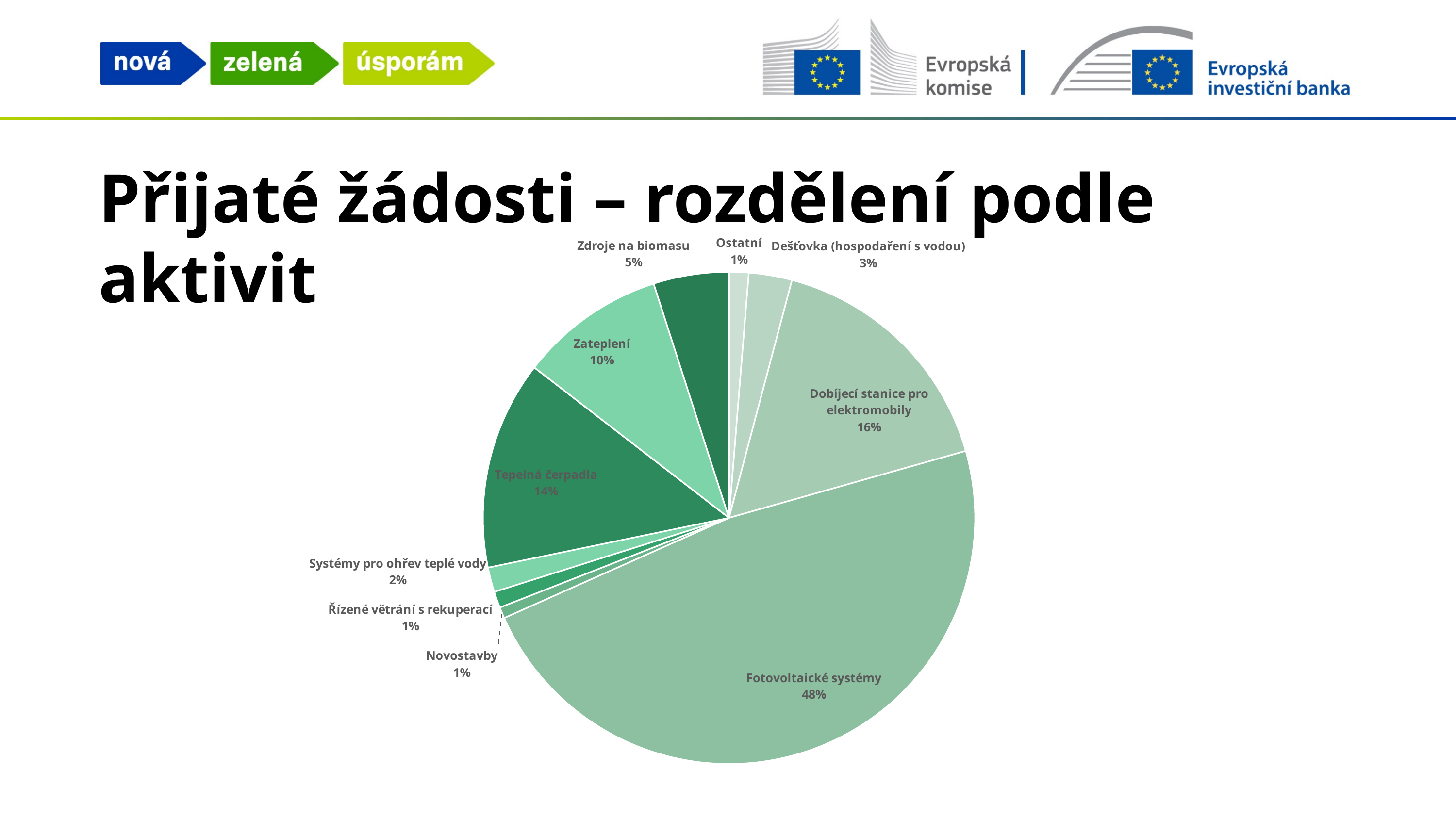
What is the value shown for Dobíjecí stanice pro elektromobily? 16% What is the difference between the shares of Fotovoltaické systémy and Dobíjecí stanice pro elektromobily? 32% What is the title of the slide containing the chart? Přijaté žádosti – rozdělení podle aktivit What share of the pie does Fotovoltaické systémy have? 48% How many categories are shown in the pie chart? 10 What is the value shown for Dešťovka (hospodaření s vodou)? 3% What is the difference between the shares of Tepelná čerpadla and Zateplení? 4% What kind of chart is shown on the slide? pie chart What is the value shown for Zateplení? 10% Which category has the largest slice of the pie? Fotovoltaické systémy What is the value shown for Tepelná čerpadla? 14% Which is larger, the share for Zateplení or the share for Zdroje na biomasu? Zateplení